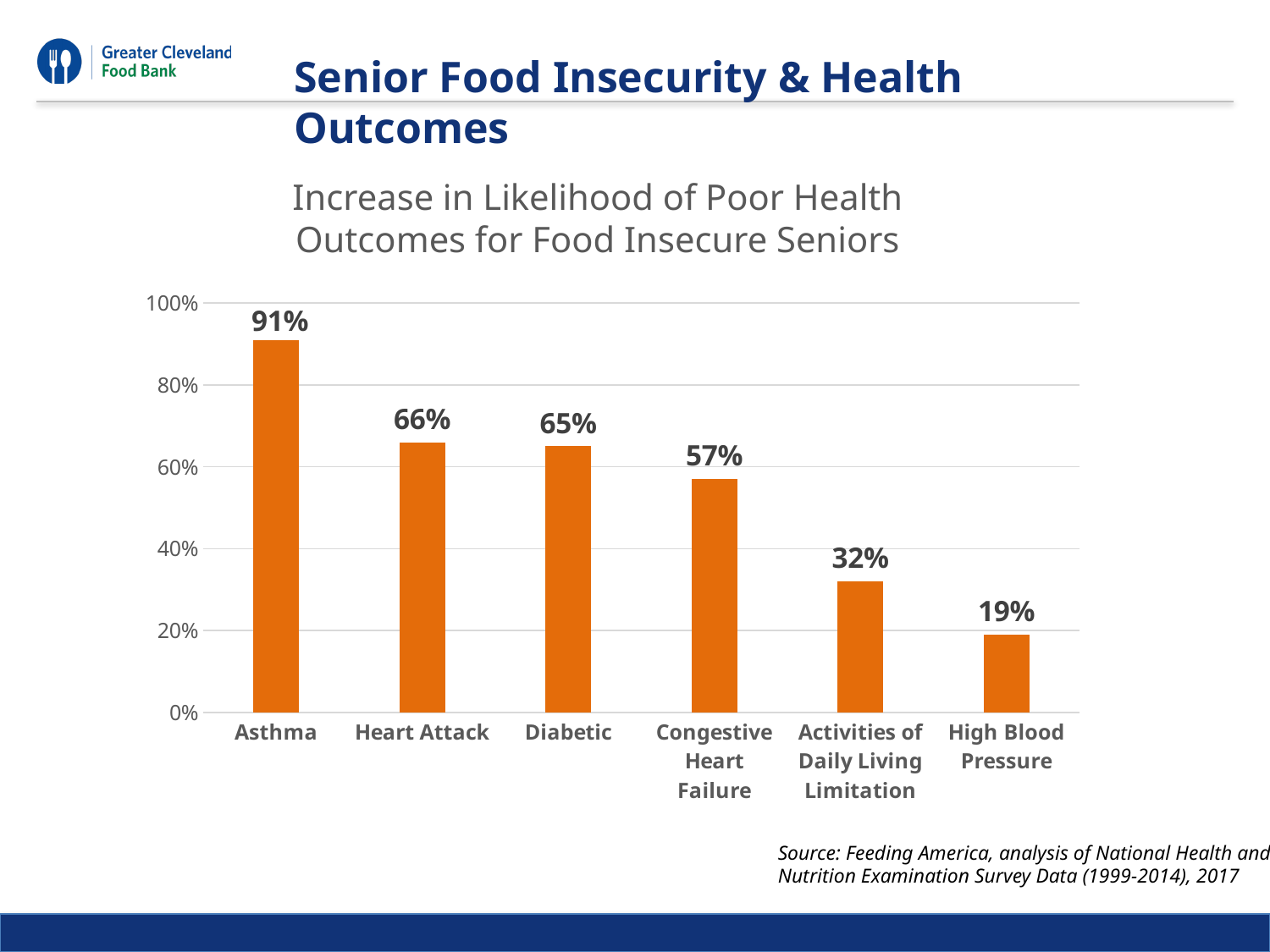
How many categories are shown on the chart? 6 What is the difference between the values for Heart Attack and Diabetic? 1% What is the value for Asthma? 91% What kind of chart is shown on the slide? bar chart What is the difference between the values for Asthma and High Blood Pressure? 72% Which is larger, the value for Congestive Heart Failure or the value for Activities of Daily Living Limitation? Congestive Heart Failure What is the value for Congestive Heart Failure? 57% Is the value for Diabetic greater or less than 60%? greater What is the title of the chart? Increase in Likelihood of Poor Health Outcomes for Food Insecure Seniors Which category has the highest value? Asthma Which category has the lowest value? High Blood Pressure What is the value for Activities of Daily Living Limitation? 32%